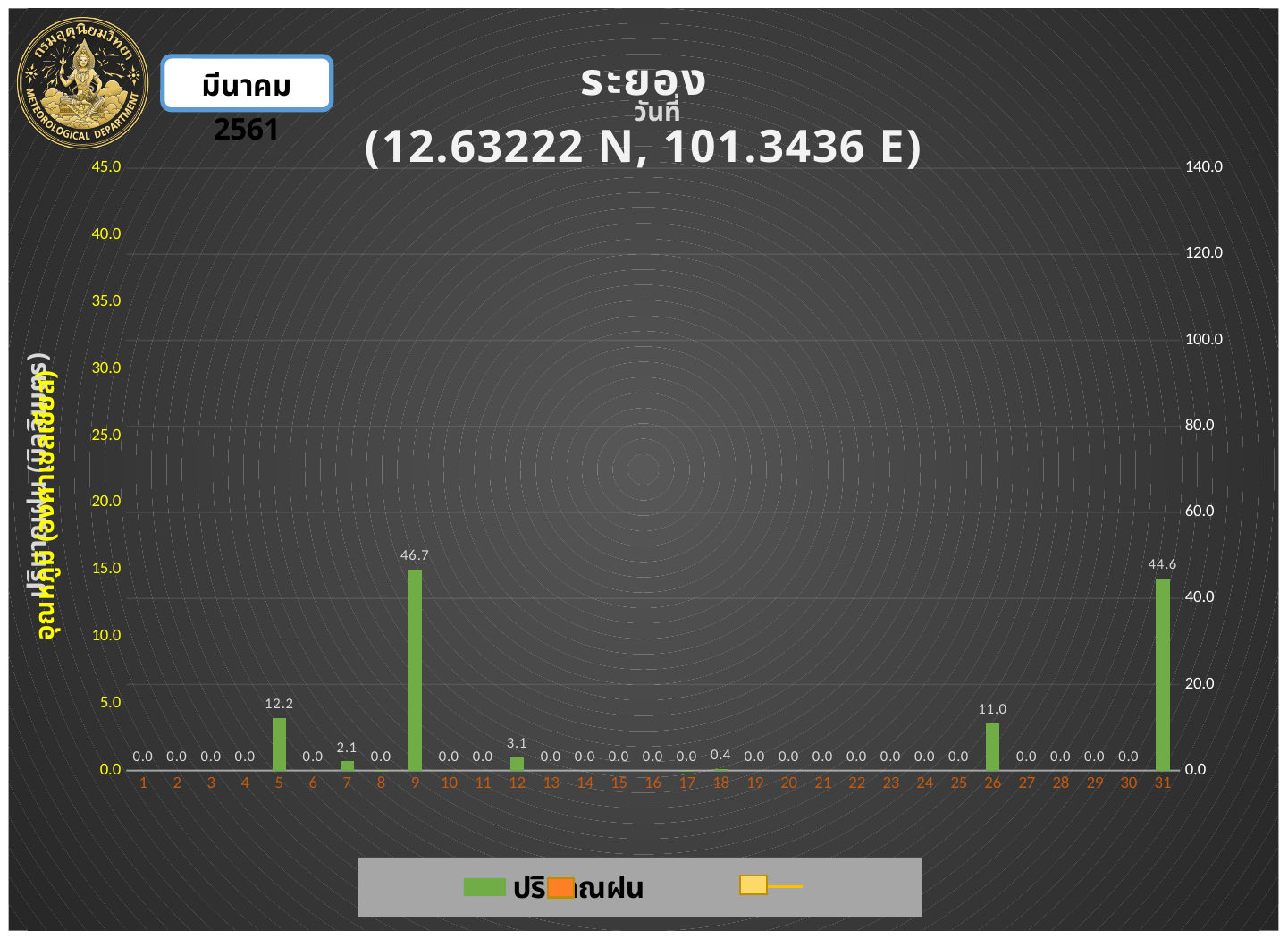
What is the rainfall value shown for day 26? 11.0 Which is larger, the rainfall value for day 5 or for day 26? day 5 What is the rainfall value shown for day 18? 0.4 What is the rainfall value shown for day 9? 46.7 What is the difference between the rainfall values for day 12 and day 7? 1.0 Which day has the highest rainfall value? 9 How many days are shown on the x axis? 31 What coordinates are given in the chart title? 12.63222 N, 101.3436 E What is the rainfall value shown for day 31? 44.6 What is the rainfall value shown for day 5? 12.2 What is the difference between the rainfall values for day 9 and day 31? 2.1 What kind of chart is shown on the slide? bar chart